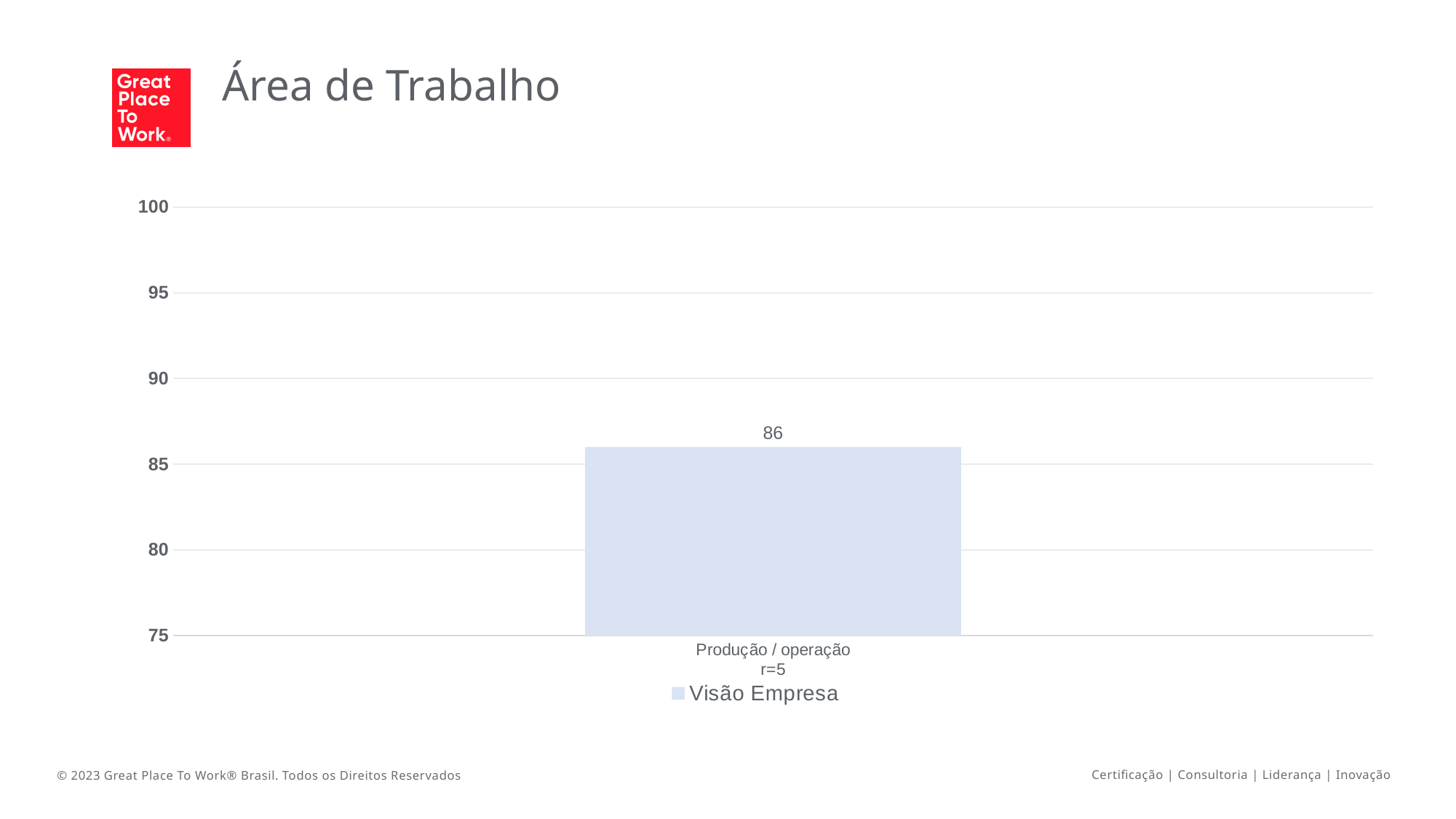
What is the name of the series shown in the legend? Visão Empresa How many categories are plotted on the chart? 1 What is the lowest value shown on the vertical axis? 75 How many series does the legend list? 1 What is the title of the slide containing the chart? Área de Trabalho Is the value for Produção / operação greater or less than 85? greater What is the respondent count (r) shown under the Produção / operação category label? r=5 What kind of chart is shown on the slide? bar chart What is the highest value shown on the vertical axis? 100 What is the value for Produção / operação? 86 Is the value for Produção / operação greater or less than 90? less